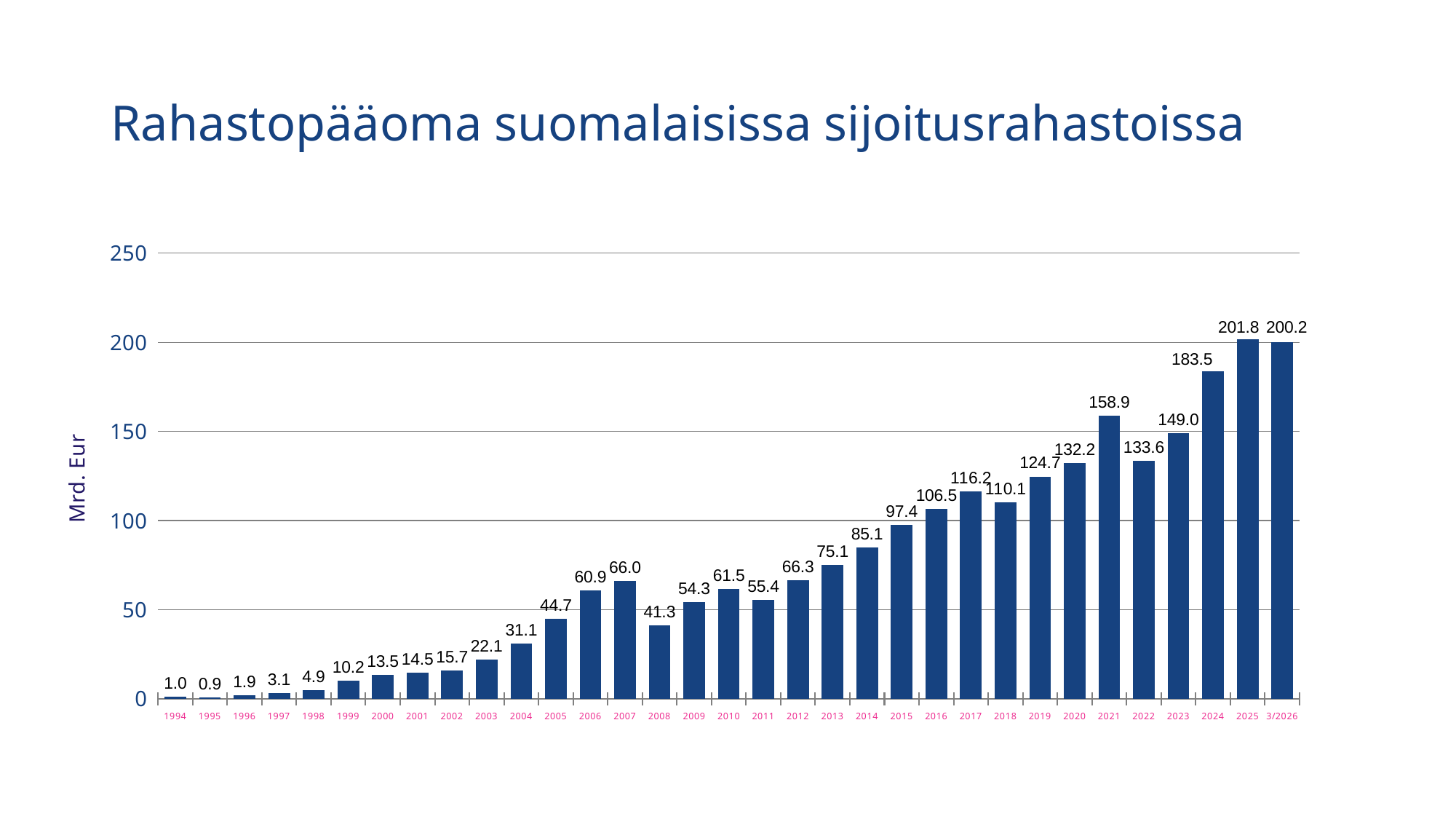
What is the value for 3/2026? 200.2 What is the value for 2021? 158.9 What is the label on the vertical axis? Mrd. Eur Is the value for 2015 greater or less than 100? less What is the difference between the values for 2007 and 2008? 24.7 What kind of chart is shown on the slide? bar chart What is the value for 2008? 41.3 What is the difference between the values for 2025 and 2024? 18.3 Which is larger, the value for 2017 or the value for 2018? 2017 Which year has the highest value? 2025 How many bars are shown in the chart? 33 Which year has the lowest value? 1995